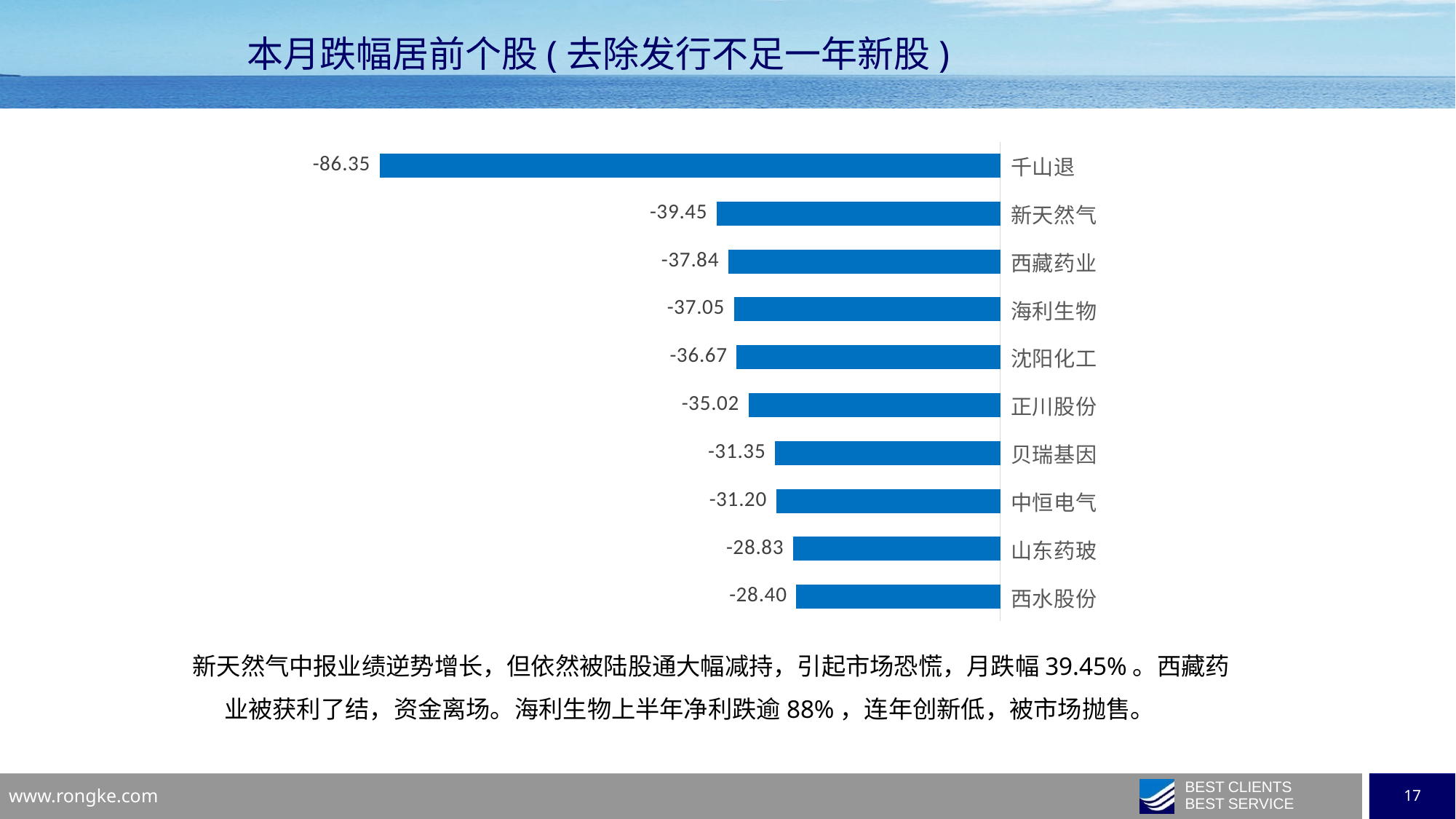
Which stock has the smallest decline (least negative value) in the chart? 西水股份 What is the value shown for 千山退? -86.35 How many stocks are shown in the chart? 10 What is the difference between the values for 西藏药业 and 海利生物? 0.79 What is the difference between the values for 千山退 and 新天然气? 46.90 What is the value shown for 新天然气? -39.45 Which stock has the largest decline (most negative value) in the chart? 千山退 What is the value shown for 西水股份? -28.40 What is the value shown for 海利生物? -37.05 What is the title of the slide? 本月跌幅居前个股（去除发行不足一年新股） What type of chart is shown on the slide? Bar chart Which stock shows a larger decline, 贝瑞基因 or 中恒电气? 贝瑞基因